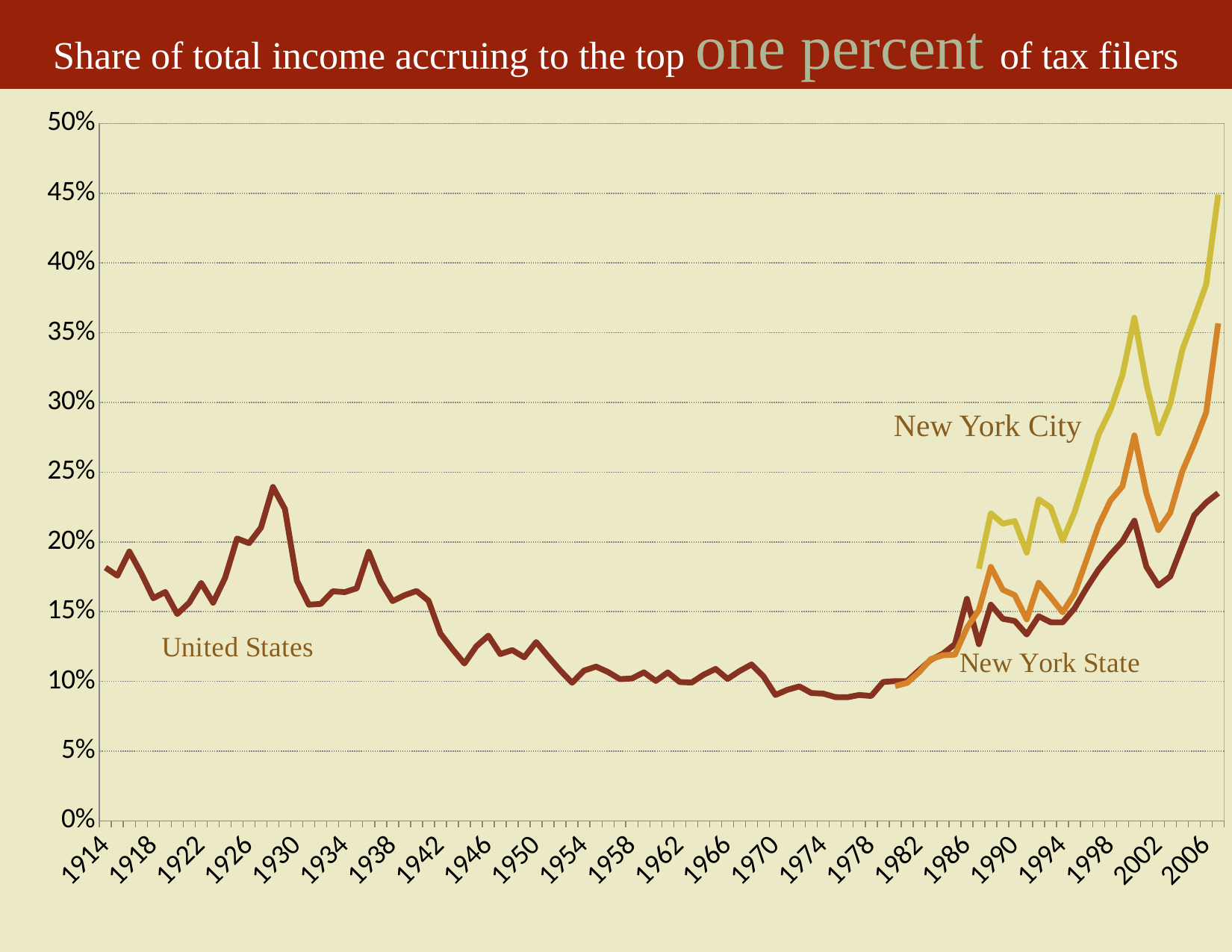
What is the title of the chart? Share of total income accruing to the top one percent of tax filers Does the United States line rise or fall overall between 1929 and 1974? fall Is the value for the United States at the right end of the chart greater or less than 25%? less Is the value for the United States in 1974 greater or less than 10%? less What kind of chart is shown on the slide? line chart Is the value for the United States at its 1929 peak greater or less than 20%? greater What are the names of the three series labelled on the chart? United States, New York State, New York City At the right end of the chart, which series has the lowest value? United States How many series (lines) are plotted on the chart? 3 At the right end of the chart, which series has the highest value? New York City